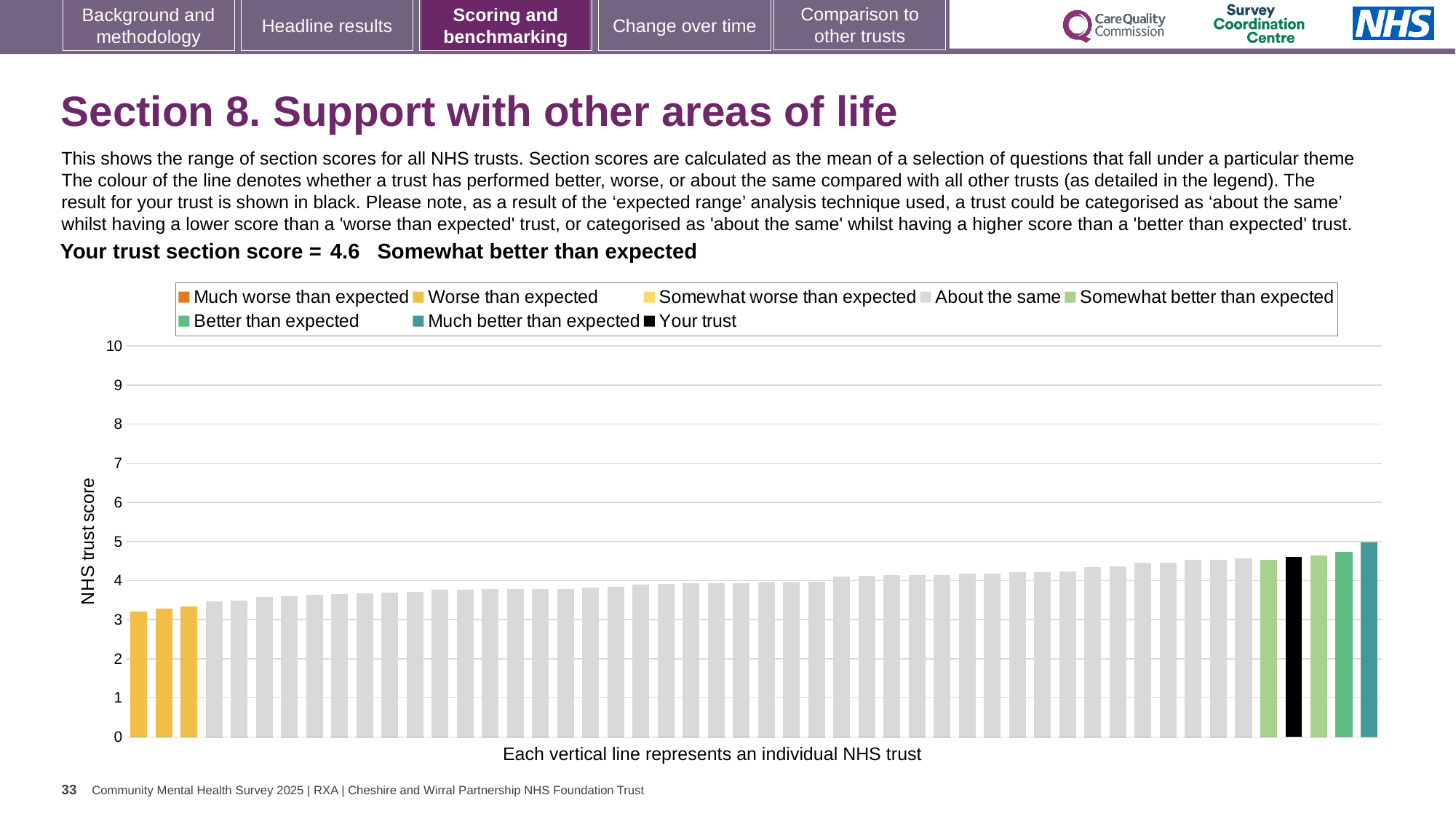
Is the value for your trust greater or less than 4? greater Is the value of the lowest-scoring trust greater or less than 4? less Do the trust scores rise or fall from left to right along the x axis? Rise What is the title of the vertical axis? NHS trust score How many trusts are shown in the 'Worse than expected' colour? 3 How many entries does the chart legend list? 8 What colour is used for the bar representing your trust? Black Is the value of the highest-scoring trust greater or less than 6? less Which legend category does the highest bar on the chart belong to? Much better than expected What is the section score for your trust shown on the slide? 4.6 Which performance category is your trust placed in for Section 8? Somewhat better than expected What kind of chart is shown on the slide? Bar chart